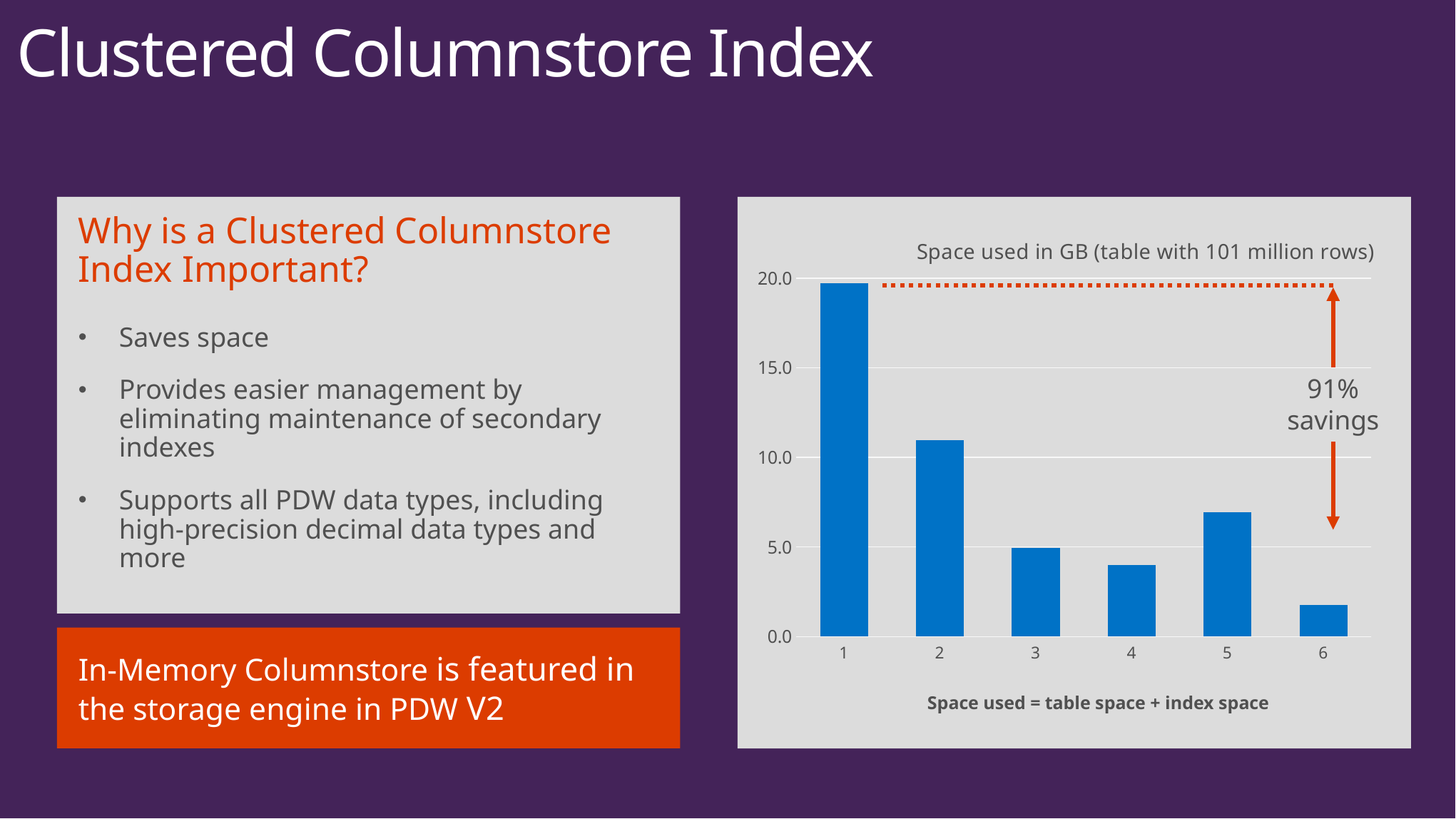
Which category has the highest space used? 1 Which uses more space, category 4 or category 5? 5 Is the value for category 4 greater or less than 5.0? less Is the value for category 6 greater or less than 5.0? less Which uses more space, category 3 or category 6? 3 Which category has the lowest space used? 6 What is the title of the chart? Space used in GB (table with 101 million rows) Which uses more space, category 1 or category 2? 1 Is the value for category 1 greater or less than 15.0? greater How many bars are plotted in the chart? 6 What kind of chart is shown on the slide? bar chart What percentage savings does the annotation on the chart indicate? 91%